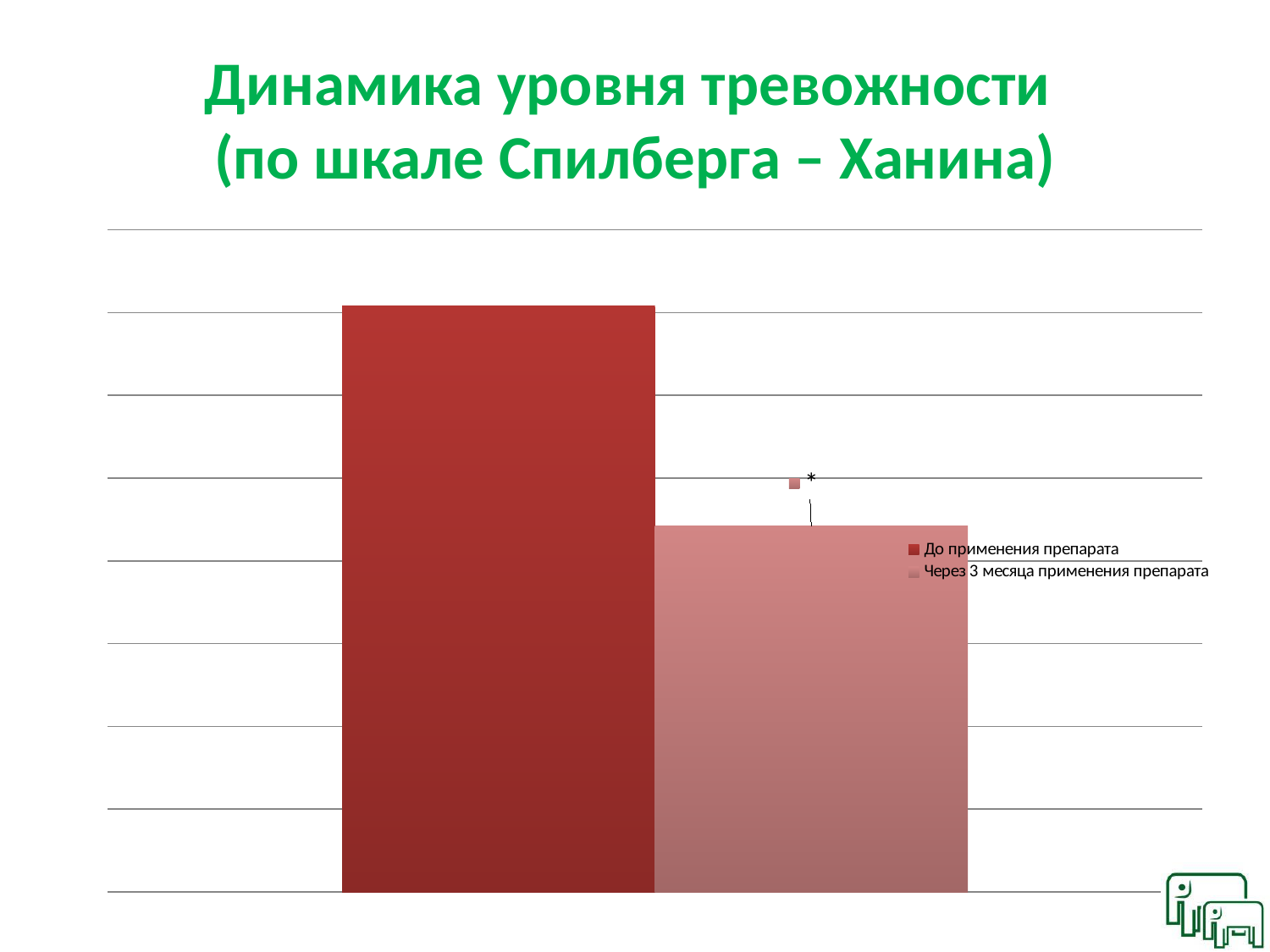
Which series has the taller bar, "До применения препарата" or "Через 3 месяца применения препарата"? До применения препарата How many series does the legend list? 2 Which series has the lowest bar in the chart? Через 3 месяца применения препарата What is the first entry listed in the chart legend? До применения препарата How many bars are plotted in the chart? 2 Does the anxiety level rise or fall from "До применения препарата" to "Через 3 месяца применения препарата"? fall What is the title of the slide containing the chart? Динамика уровня тревожности (по шкале Спилберга – Ханина) Which series has the highest bar in the chart? До применения препарата What kind of chart is shown on the slide? bar chart